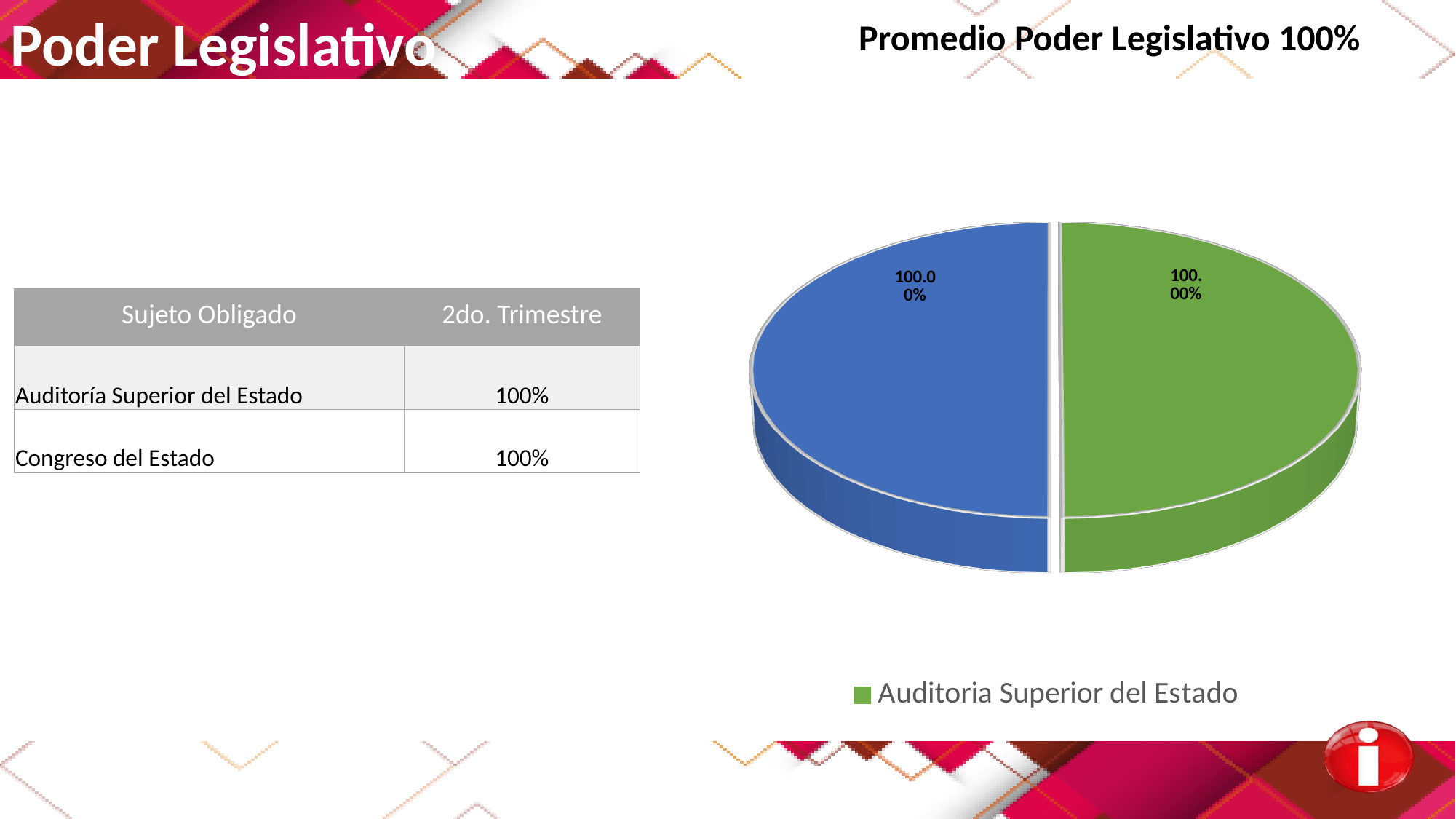
What colour is the Auditoria Superior del Estado slice in the pie chart? green How many slices does the pie chart have? 2 Which entry is listed in the pie chart's legend? Auditoria Superior del Estado What value is printed on the Auditoria Superior del Estado slice of the pie chart? 100.00% What value is printed on the blue slice of the pie chart? 100.00% What kind of chart is shown on the slide? pie chart How many entries does the pie chart's legend list? 1